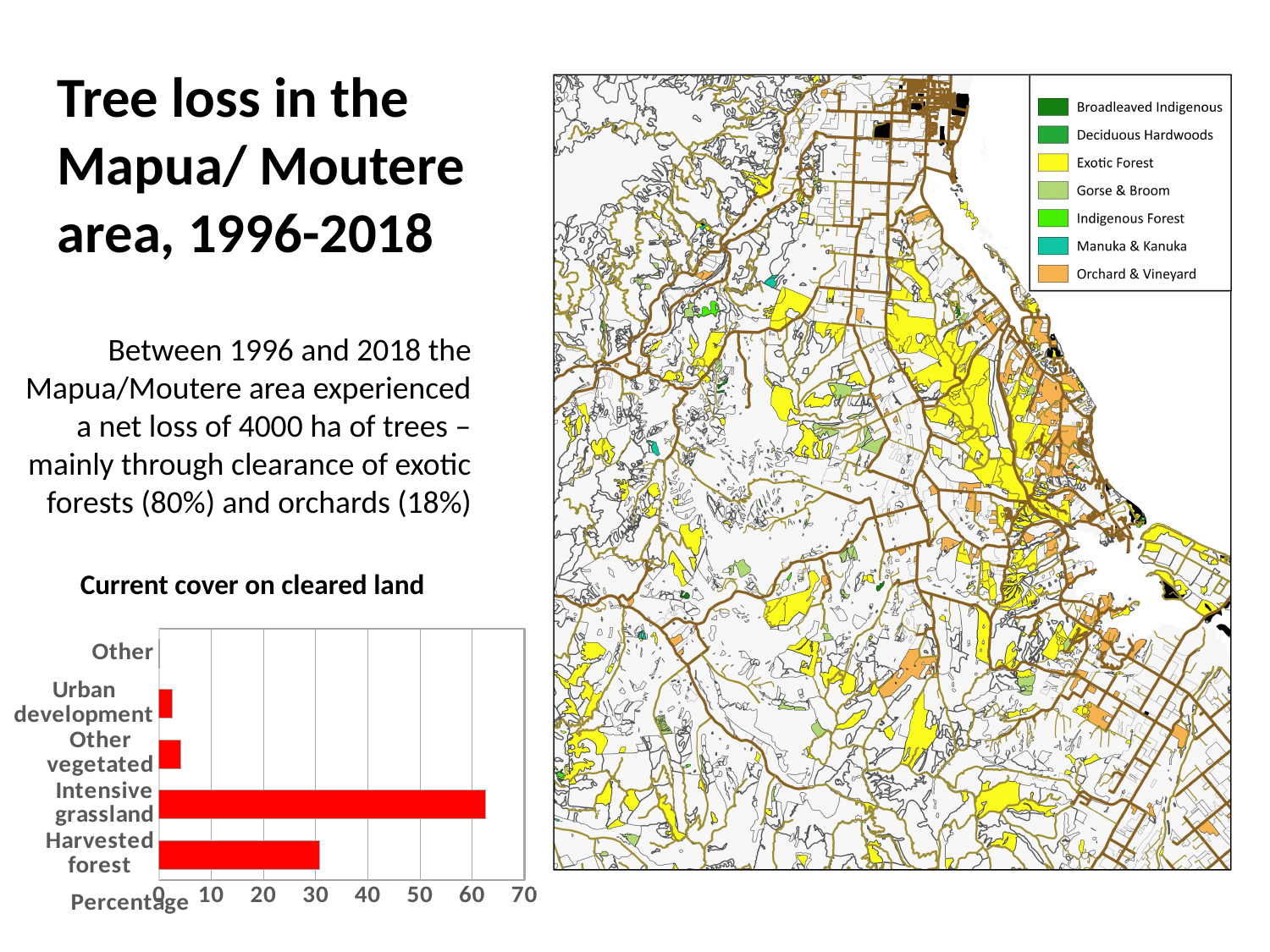
In the 'Current cover on cleared land' chart, which is larger: Intensive grassland or Harvested forest? Intensive grassland What is the label of the horizontal axis in the 'Current cover on cleared land' chart? Percentage What is the title of the bar chart on the slide? Current cover on cleared land In the 'Current cover on cleared land' chart, is the value for Harvested forest greater or less than 40? less In the 'Current cover on cleared land' chart, which category has the lowest percentage? Other In the 'Current cover on cleared land' chart, is the value for Urban development greater or less than 10? less In the 'Current cover on cleared land' chart, is the value for Harvested forest greater or less than 20? greater In the 'Current cover on cleared land' chart, which category has the highest percentage? Intensive grassland In the 'Current cover on cleared land' chart, which is larger: Harvested forest or Other vegetated? Harvested forest What kind of chart is 'Current cover on cleared land'? bar chart How many categories are shown in the 'Current cover on cleared land' chart? 5